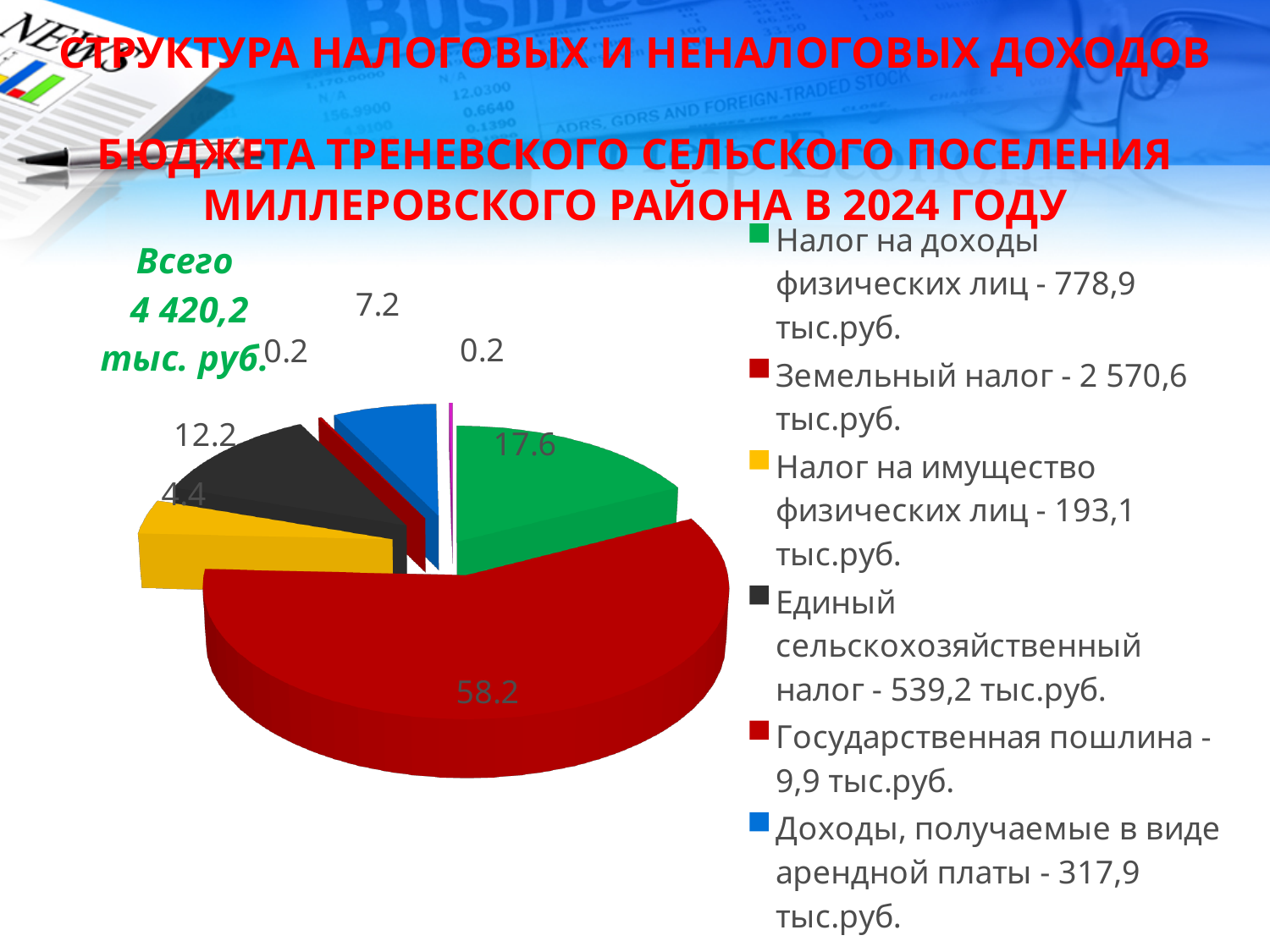
What is the difference between the Земельный налог slice (58.2) and the Налог на доходы физических лиц slice (17.6)? 40.6 What value is labelled on the green slice (Налог на доходы физических лиц)? 17.6 How many slices does the pie chart have? 7 What total amount is stated next to the pie chart (Всего)? 4 420,2 тыс. руб. What value is labelled on the blue slice (Доходы, получаемые в виде арендной платы)? 7.2 Which category has the largest slice in the pie chart? Земельный налог What value is labelled on the black slice (Единый сельскохозяйственный налог)? 12.2 What value is labelled on the yellow slice (Налог на имущество физических лиц)? 4.4 Which slice is larger: Единый сельскохозяйственный налог or Налог на имущество физических лиц? Единый сельскохозяйственный налог What kind of chart is shown on the slide? pie chart What percentage share does the Земельный налог slice have in the pie chart? 58.2 According to the legend, what is the amount of Земельный налог in тыс.руб.? 2 570,6 тыс.руб.